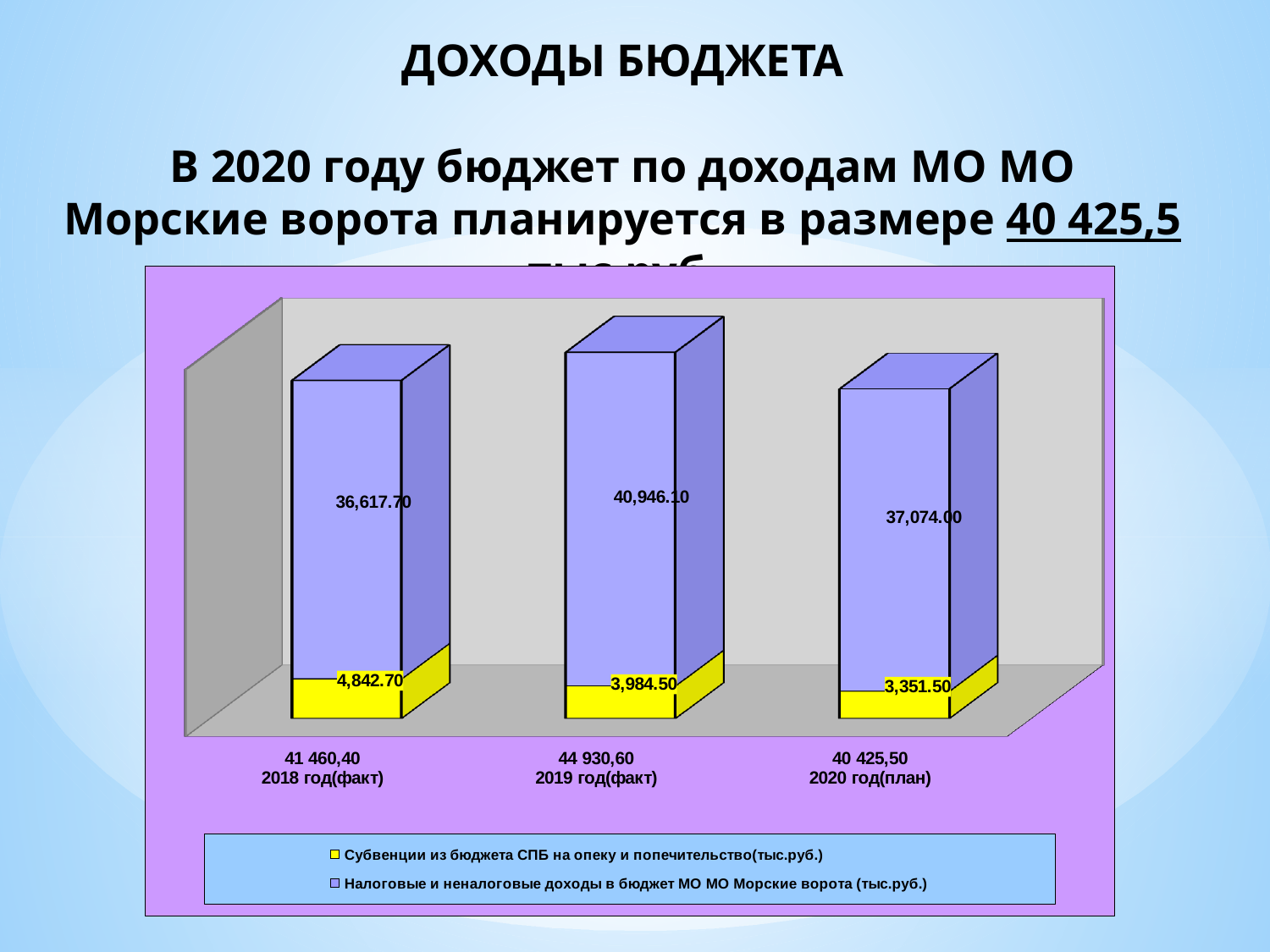
What is the value of 'Налоговые и неналоговые доходы' for 2020 год(план)? 37,074.00 Which year has the lowest value for 'Субвенции из бюджета СПБ на опеку и попечительство'? 2020 год(план) What type of chart is shown on the slide? bar chart How many categories (years) are shown on the x axis? 3 Which year has the highest value for 'Налоговые и неналоговые доходы'? 2019 год(факт) Which is larger: 'Налоговые и неналоговые доходы' for 2018 год(факт) or for 2020 год(план)? 2020 год(план) What is the value of 'Субвенции из бюджета СПБ на опеку и попечительство(тыс.руб.)' for 2018 год(факт)? 4,842.70 What is the difference between the 'Субвенции' values for 2018 год(факт) and 2019 год(факт)? 858.20 Which colour represents 'Субвенции из бюджета СПБ на опеку и попечительство(тыс.руб.)' in the chart? yellow How many series does the legend list? 2 What is the value of 'Налоговые и неналоговые доходы в бюджет МО МО Морские ворота (тыс.руб.)' for 2019 год(факт)? 40,946.10 What is the total of the stacked bar for 2019 год(факт)? 44 930,60